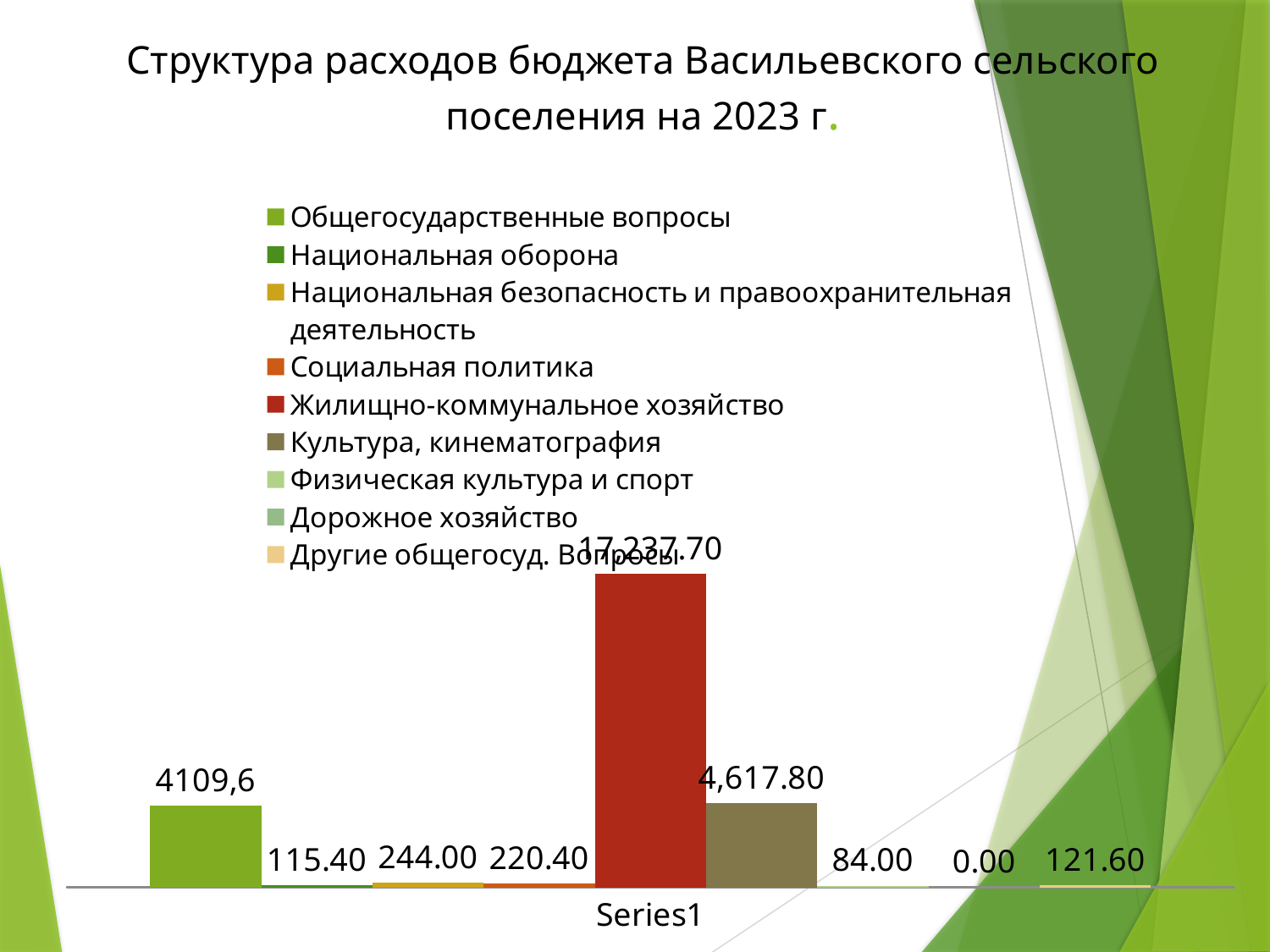
Which is larger, the value for Национальная безопасность и правоохранительная деятельность or the value for Другие общегосуд. Вопросы? Национальная безопасность и правоохранительная деятельность What is the value for Социальная политика? 220.40 Which series has the lowest value? Дорожное хозяйство What is the title of the chart? Структура расходов бюджета Васильевского сельского поселения на 2023 г. What is the value for Национальная оборона? 115.40 How many series does the legend list? 9 What type of chart is shown on the slide? bar chart What is the value for Культура, кинематография? 4,617.80 What is the value for Жилищно-коммунальное хозяйство? 17,237.70 Which series has the highest value? Жилищно-коммунальное хозяйство What is the value for Дорожное хозяйство? 0.00 What is the difference between the values for Национальная безопасность и правоохранительная деятельность and Социальная политика? 23.60